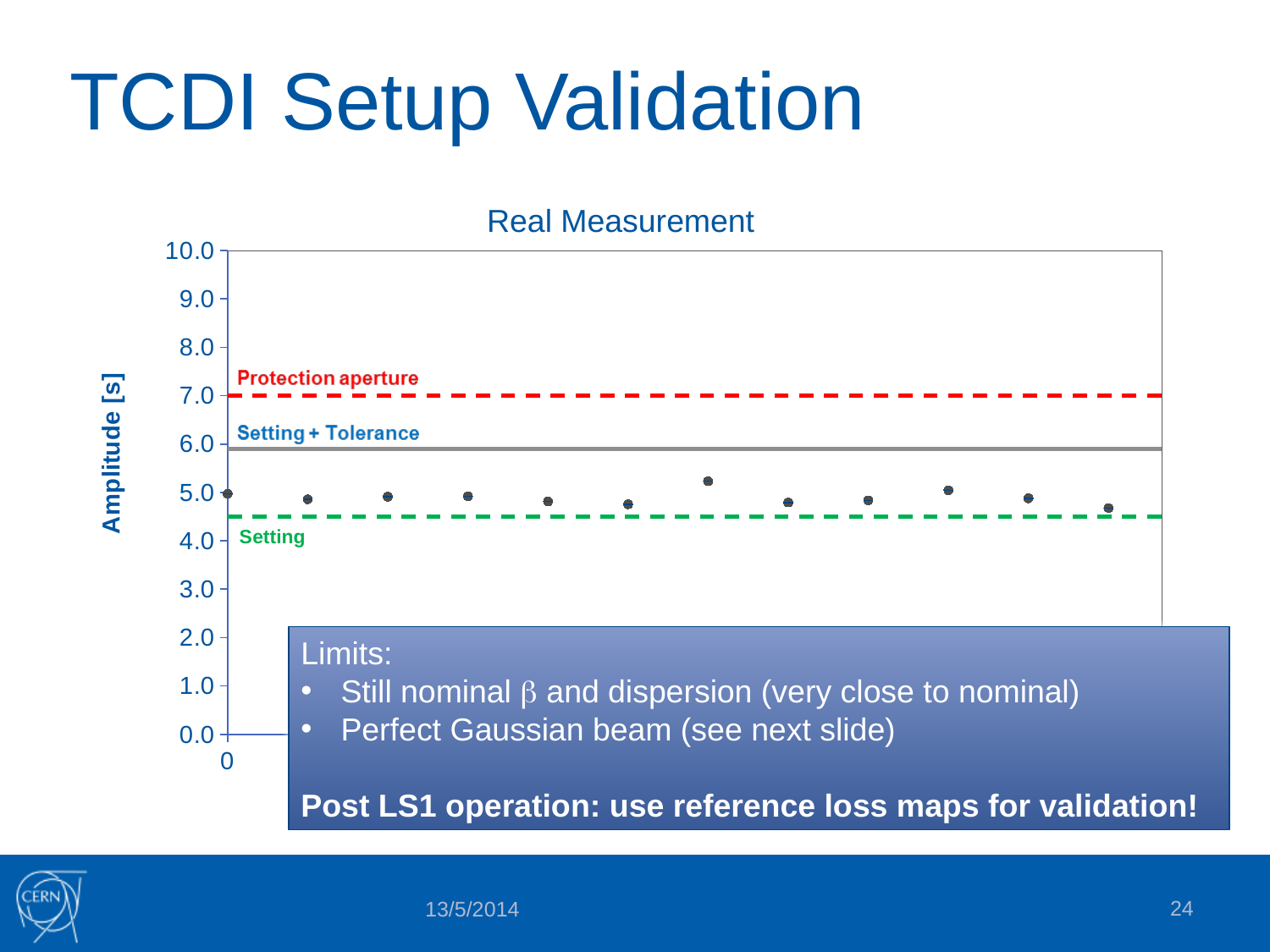
At what amplitude value is the red dashed 'Protection aperture' line drawn? 7.0 What is the label of the y-axis? Amplitude [s] What is the title of the chart? Real Measurement Is the 'Setting' line greater or less than 4.0? greater How many measured data points are plotted on the chart? 12 What type of chart is shown on the slide? Scatter chart Is the 'Setting + Tolerance' line greater or less than 7.0? less What is the maximum value shown on the y-axis? 10.0 Is the 'Setting' line greater or less than 5.0? less Which is higher on the chart, the 'Protection aperture' line or the 'Setting + Tolerance' line? Protection aperture